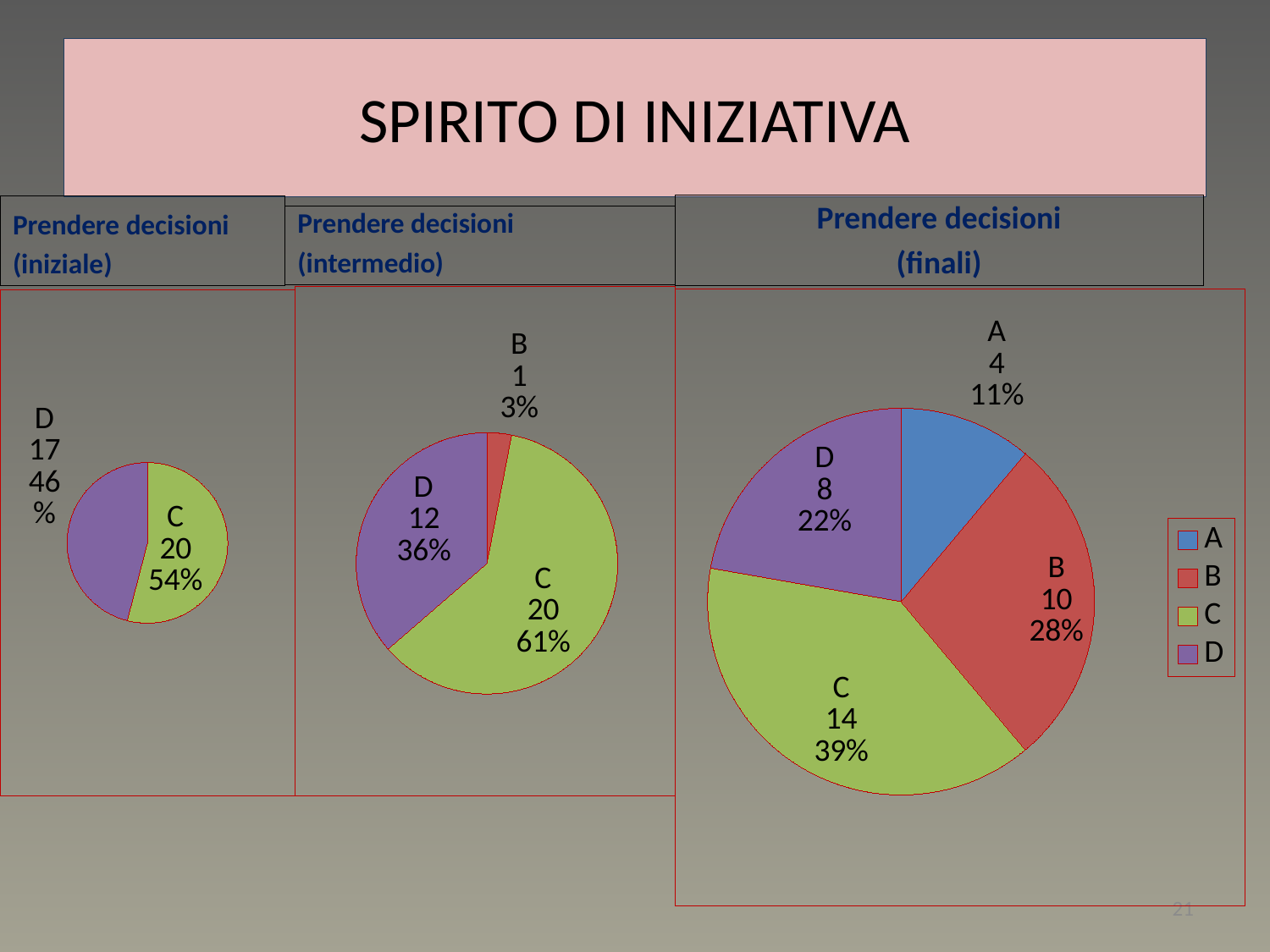
What type of chart is used for 'Prendere decisioni (iniziale)'? Pie chart In the 'Prendere decisioni (finali)' chart, which category has the smallest slice? A In the 'Prendere decisioni (intermedio)' chart, what value is shown for category D? 12 In the 'Prendere decisioni (finali)' chart, what is the difference between the values for B and D? 2 In the 'Prendere decisioni (iniziale)' chart, what percentage share does category C have? 54% In the 'Prendere decisioni (finali)' chart, what percentage share does category B have? 28% How many entries does the legend next to the 'Prendere decisioni (finali)' chart list? 4 In the 'Prendere decisioni (intermedio)' chart, which is larger, the value for C or the value for D? C In the 'Prendere decisioni (finali)' chart, what value is shown for category C? 14 How many slices does the 'Prendere decisioni (finali)' pie chart have? 4 In the 'Prendere decisioni (intermedio)' chart, which category has the smallest slice? B In the 'Prendere decisioni (finali)' chart, which category has the largest slice? C